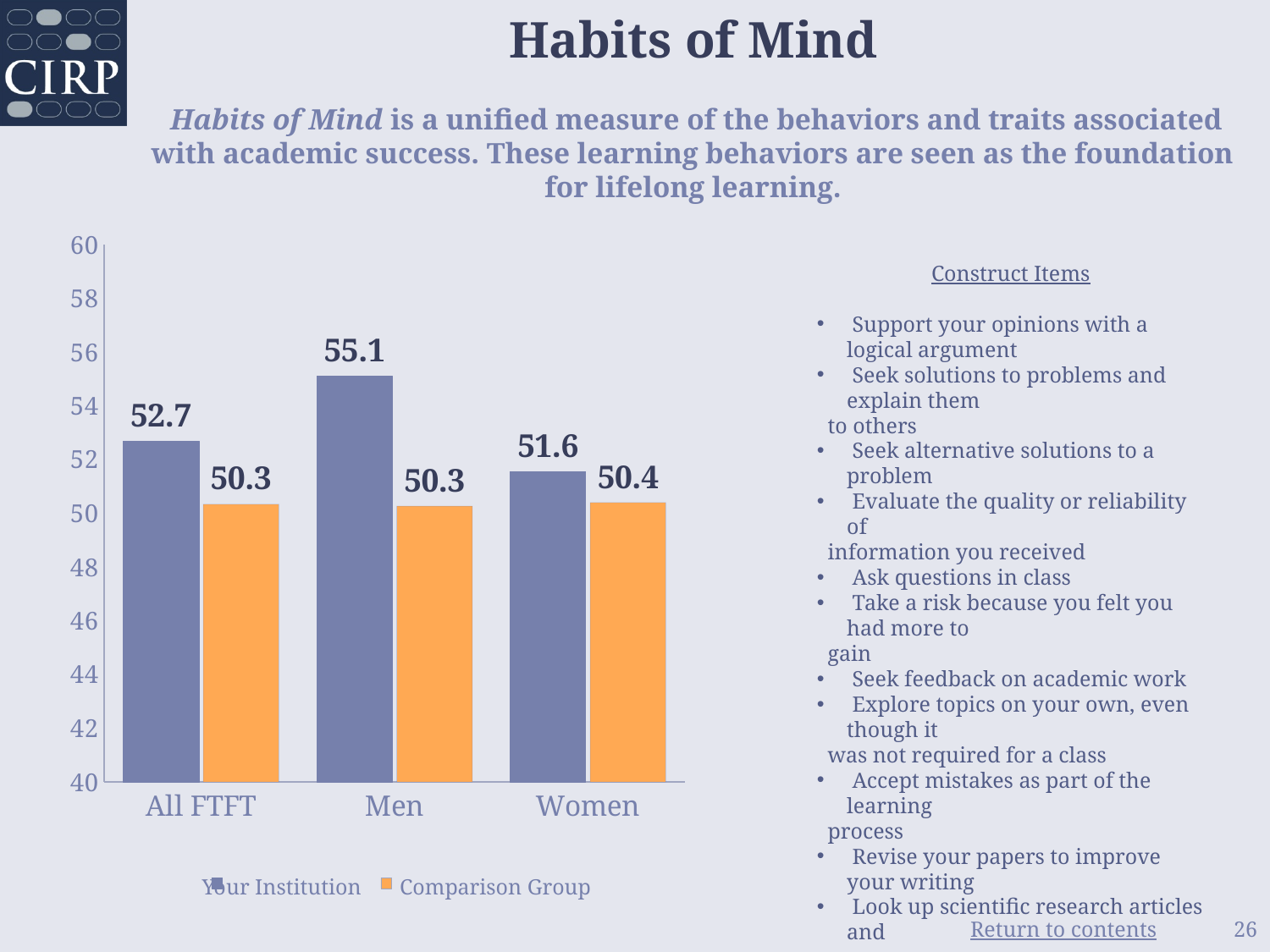
Which category has the highest Your Institution value? Men Is the Your Institution value for Men greater or less than 54? greater How many categories are shown on the x axis? 3 What is the Comparison Group value for Women? 50.4 What kind of chart is shown on the slide? bar chart Which category has the lowest Your Institution value? Women What is the difference between the Your Institution and Comparison Group values for Men? 4.8 How many series does the legend list? 2 Which is larger for Women: the Your Institution value or the Comparison Group value? Your Institution What is the Your Institution value for Men? 55.1 What is the Your Institution value for All FTFT? 52.7 What is the difference between the Your Institution and Comparison Group values for All FTFT? 2.4